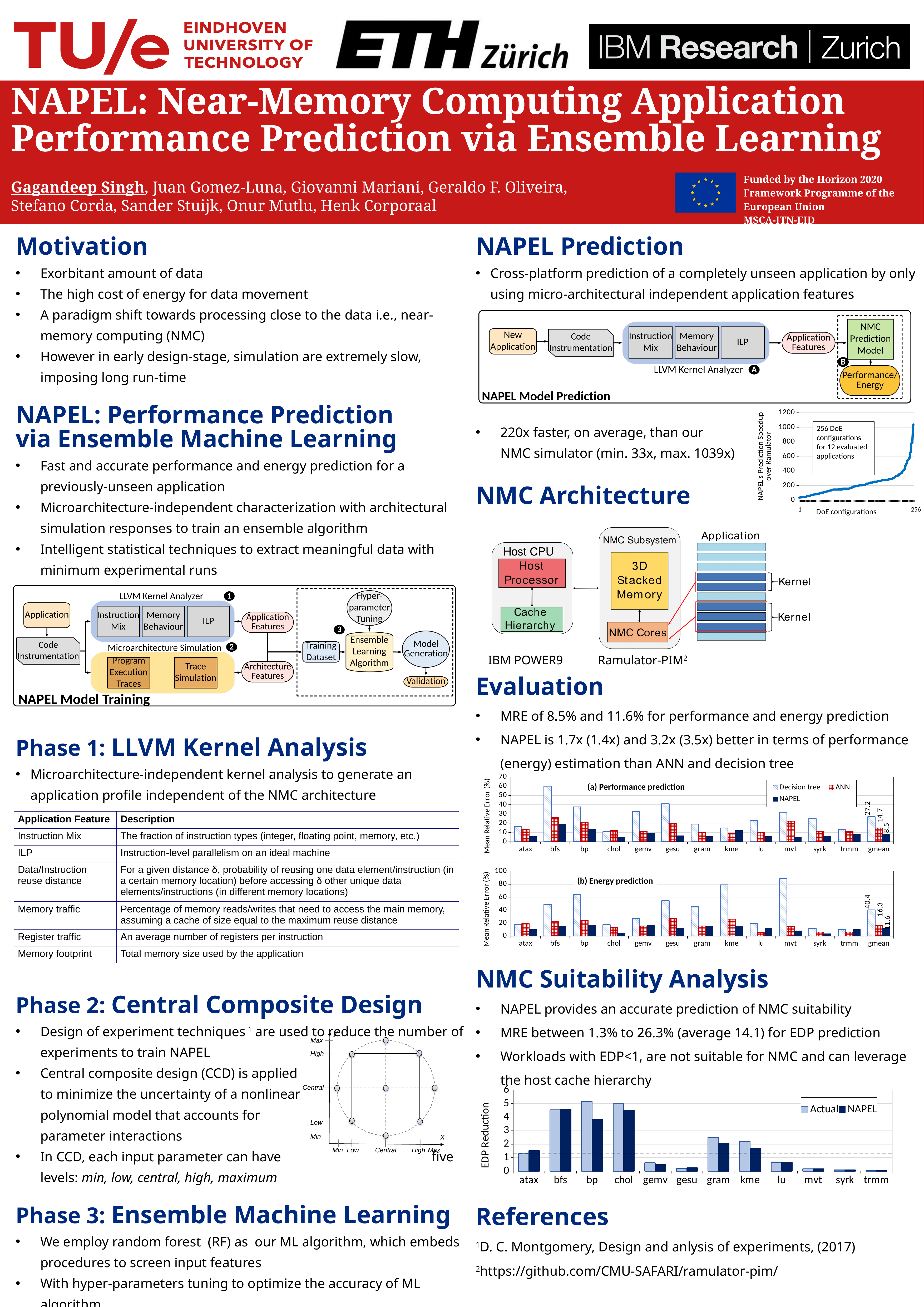
How many series does the legend of the (a) Performance prediction chart list? 3 In the EDP Reduction chart, is the Actual value for gemv greater or less than 1? less In the chart of NAPEL's Prediction Speedup over Ramulator, do the values rise or fall as the DoE configurations go from 1 to 256? rise In the (b) Energy prediction chart, what is the difference between the Decision tree and NAPEL values for gmean? 28.8 In the (b) Energy prediction chart, what is the NAPEL value for gmean? 11.6 In the (b) Energy prediction chart, what is the ANN value for gmean? 16.3 In the EDP Reduction chart, which is larger for bp, the Actual value or the NAPEL value? Actual In the (a) Performance prediction chart, is the Decision tree value for bfs greater or less than 50? greater In the (b) Energy prediction chart, which category has the highest Decision tree value? mvt In the (a) Performance prediction chart, what is the difference between the Decision tree and NAPEL values for gmean? 18.7 In the (a) Performance prediction chart, what is the Decision tree value for gmean? 27.2 In the (a) Performance prediction chart, which category has the highest Decision tree value? bfs